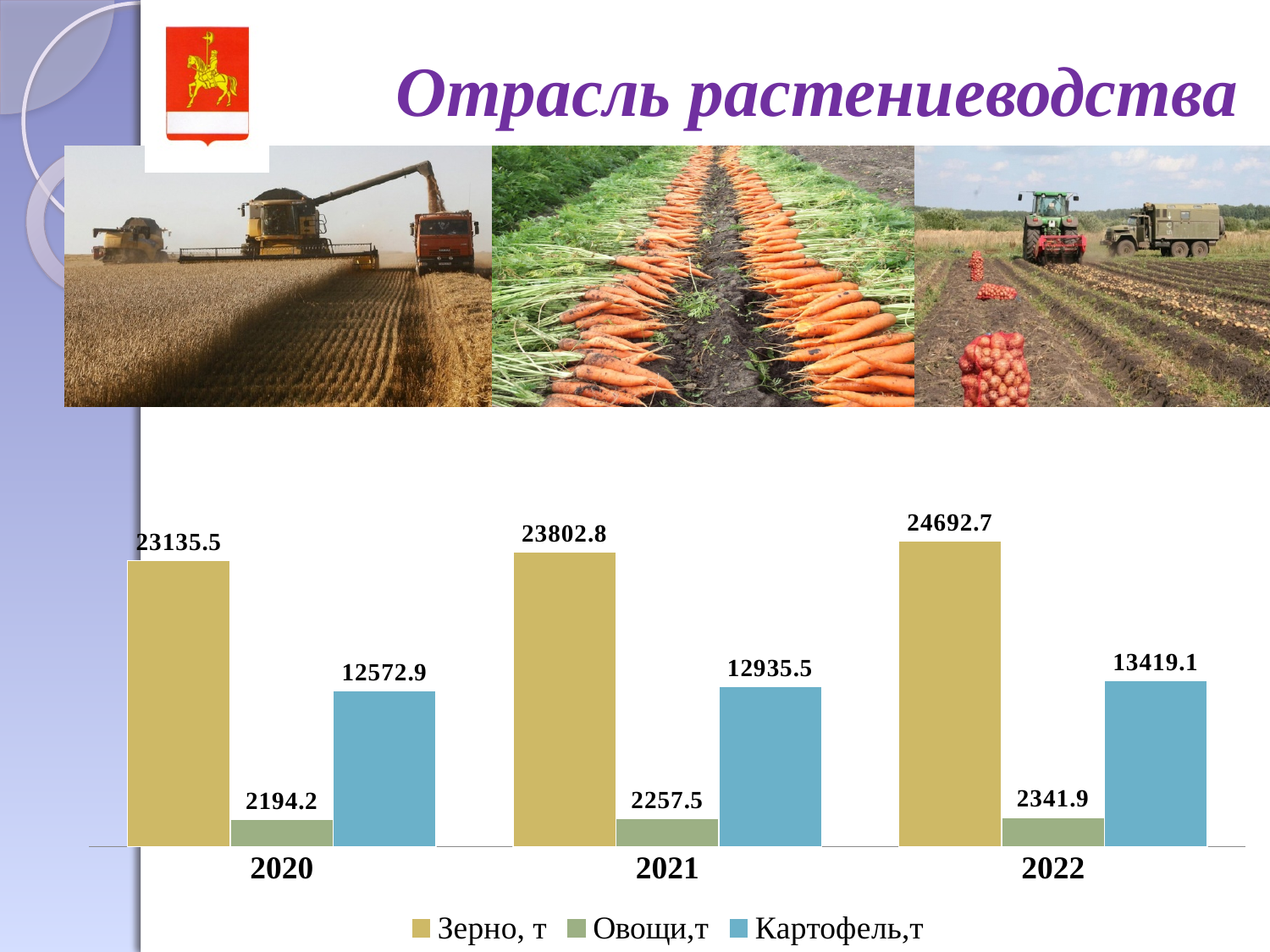
In which year is the value for Овощи,т the lowest? 2020 What is the difference between the Картофель,т values for 2022 and 2020? 846.2 Do the values for Зерно, т rise or fall from 2020 to 2022? Rise What is the value for Зерно, т in 2022? 24692.7 What is the difference between the Зерно, т values for 2022 and 2020? 1557.2 How many years are shown on the x axis of the chart? 3 Which is larger: Картофель,т in 2021 or Картофель,т in 2022? Картофель,т in 2022 What is the value for Картофель,т in 2020? 12572.9 In which year is the value for Зерно, т the highest? 2022 What kind of chart is shown on the slide? Bar chart What is the value for Овощи,т in 2021? 2257.5 How many series does the legend list? 3